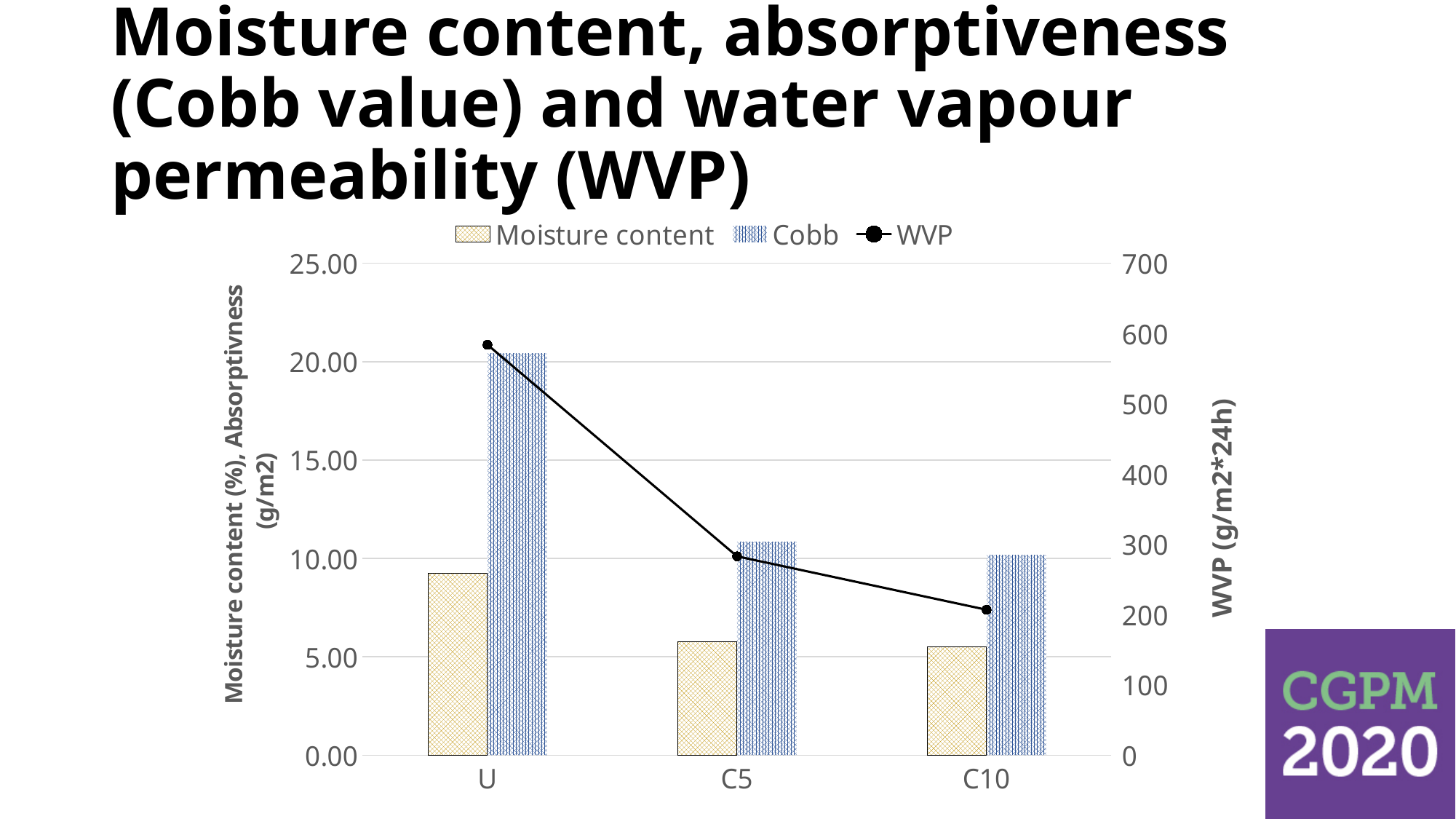
Is the Cobb value for U greater or less than 15.00? greater How many categories are shown on the x axis? 3 How many series does the legend list? 3 Is the Moisture content for U greater or less than 10.00? less Is the WVP value for C10 greater or less than 300? less Does the WVP line rise or fall from U to C10? Fall Which category has the lowest WVP value? C10 What kind of chart is shown on the slide? Combined bar and line chart Which category has the highest Cobb value? U Which category has the highest Moisture content? U Which category has the highest WVP value? U